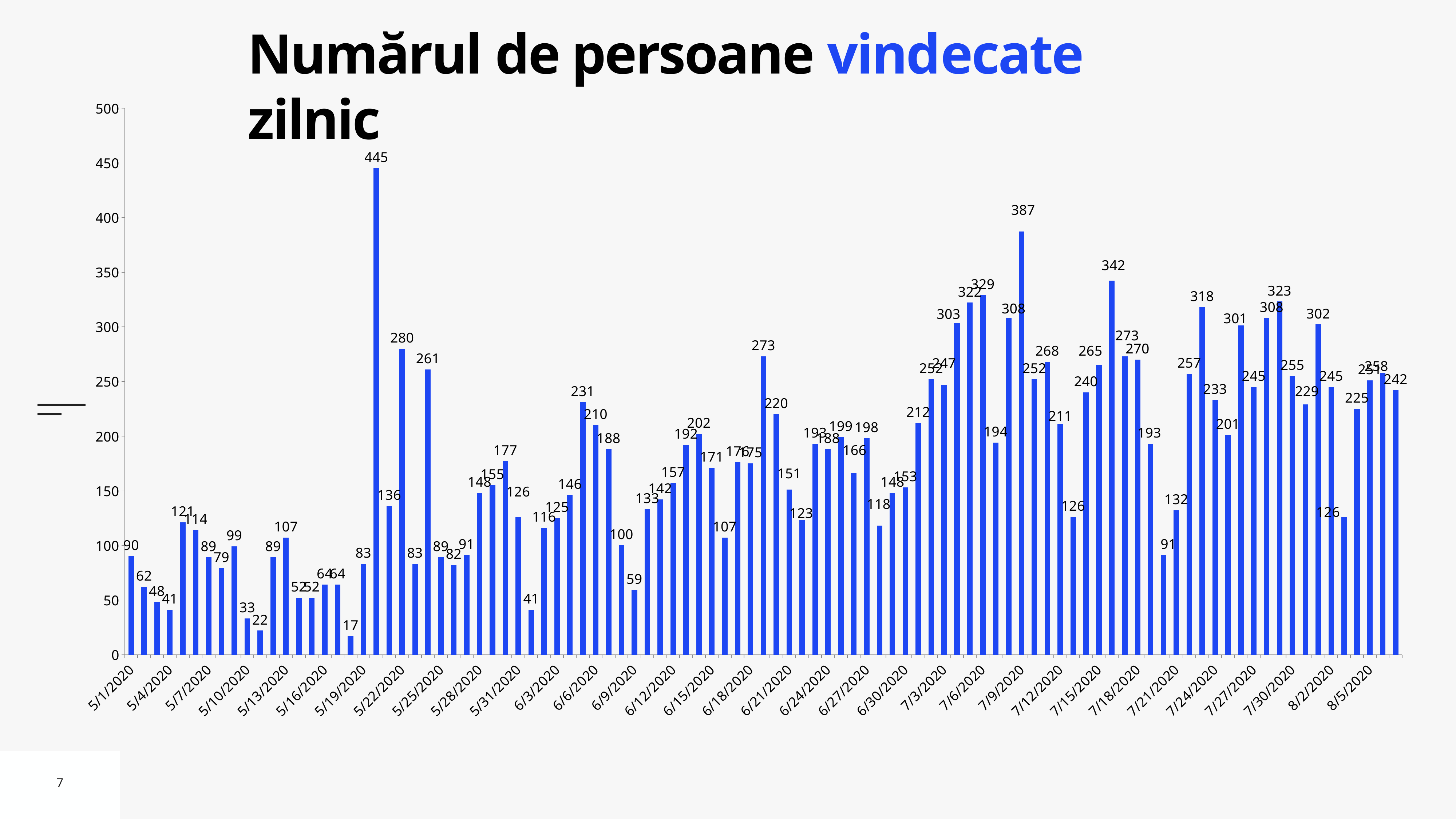
What is the lowest daily value shown in the chart? 17 What is the value for 6/9/2020? 59 What is the highest daily value shown in the chart? 445 What is the value for 7/6/2020? 329 What is the title of the chart? Numărul de persoane vindecate zilnic What kind of chart is shown on the slide? bar chart Which date has the larger value, 7/3/2020 or 7/15/2020? 7/15/2020 What is the difference between the values for 7/9/2020 and 7/6/2020? 58 What is the value for 5/1/2020? 90 What is the value for 8/5/2020? 251 What is the value for 7/9/2020? 387 Is the value for 5/22/2020 greater or less than 250? greater